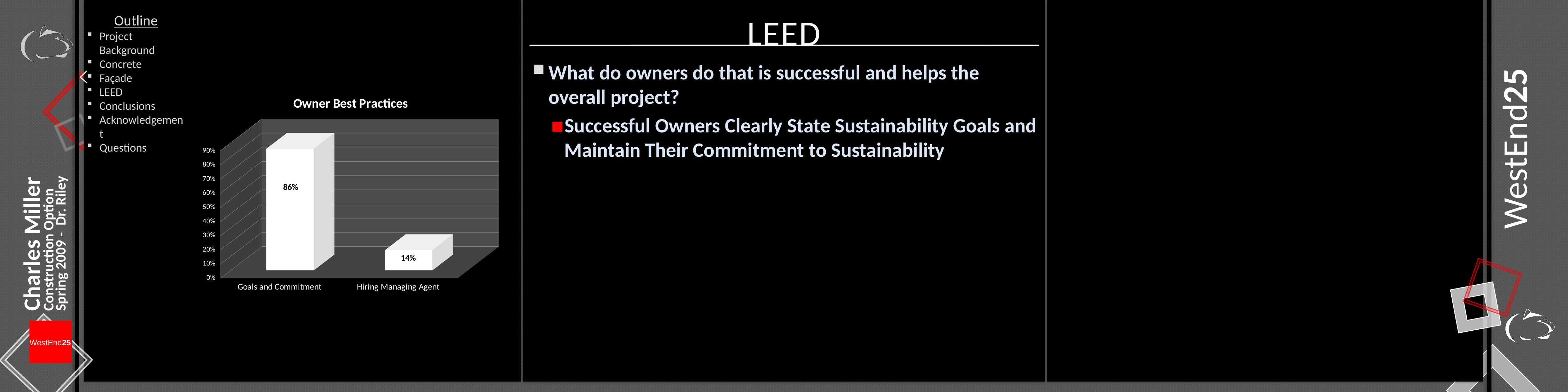
Which category has the lowest value in the Owner Best Practices chart? Hiring Managing Agent Is the value for Goals and Commitment greater or less than 50%? greater What is the value for Goals and Commitment in the Owner Best Practices chart? 86% What kind of chart is shown on the slide? Bar chart What is the difference between the values for Goals and Commitment and Hiring Managing Agent? 72% What is the title of the chart on the slide? Owner Best Practices What is the highest value shown on the vertical axis of the chart? 90% Which category has the highest value in the Owner Best Practices chart? Goals and Commitment Which is larger: the value for Goals and Commitment or the value for Hiring Managing Agent? Goals and Commitment How many categories are shown in the Owner Best Practices chart? 2 Is the value for Hiring Managing Agent greater or less than 20%? less What is the value for Hiring Managing Agent in the Owner Best Practices chart? 14%